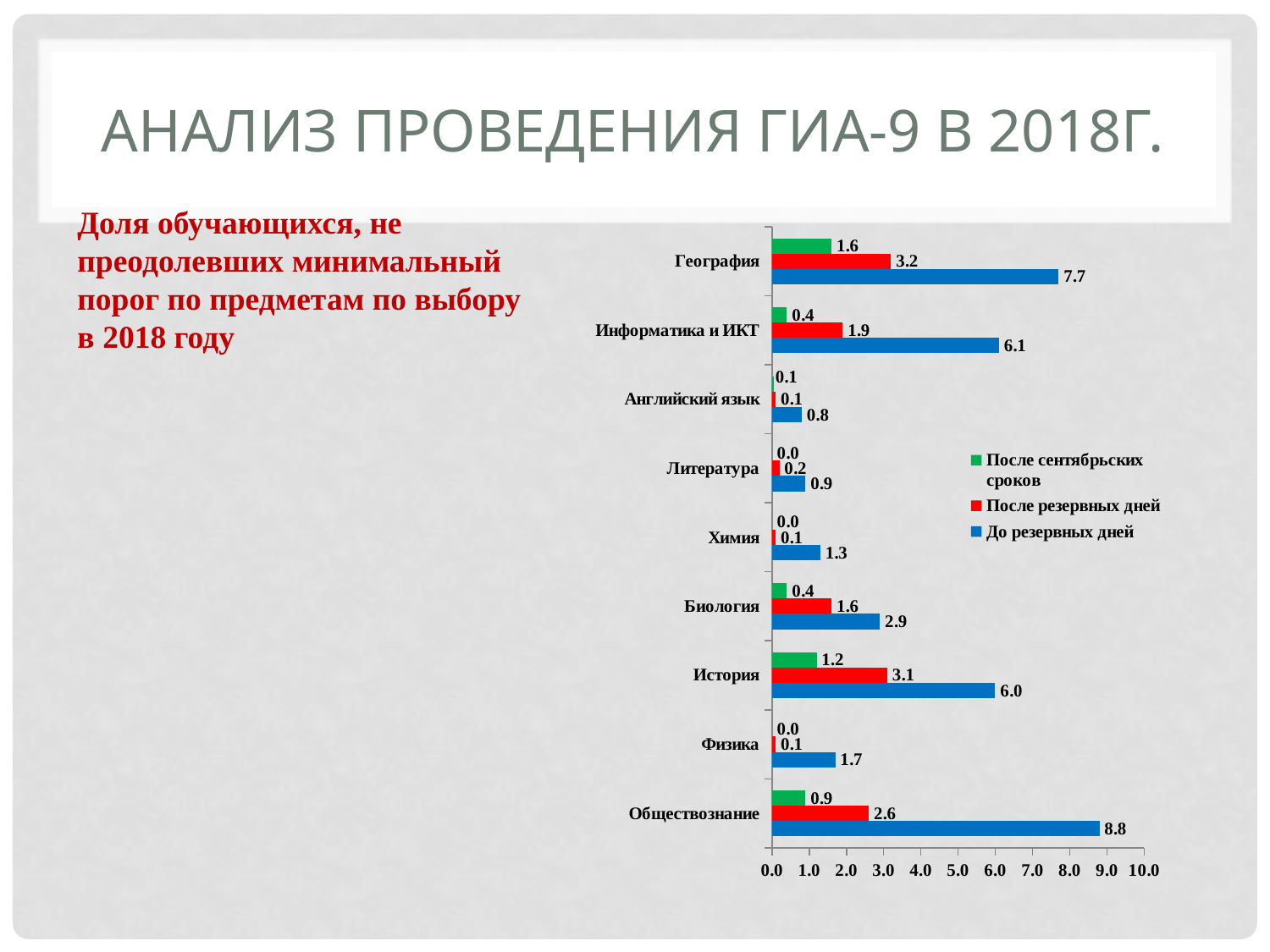
What is the value for География in the series 'До резервных дней'? 7.7 Which subject has the lowest value in the series 'До резервных дней'? Английский язык How many series does the legend list? 3 What is the value for История in the series 'После резервных дней'? 3.1 How many subjects (categories) are shown on the chart? 9 Which is larger: the 'После резервных дней' value for География or for Информатика и ИКТ? География What is the difference between the 'До резервных дней' values for Обществознание and География? 1.1 What type of chart is shown on the slide? Bar chart What is the value for Обществознание in the series 'После сентябрьских сроков'? 0.9 Which subject has the highest value in the series 'До резервных дней'? Обществознание Is the 'До резервных дней' value for История greater or less than 5.0? greater Which colour represents the series 'После сентябрьских сроков' in the legend? Green